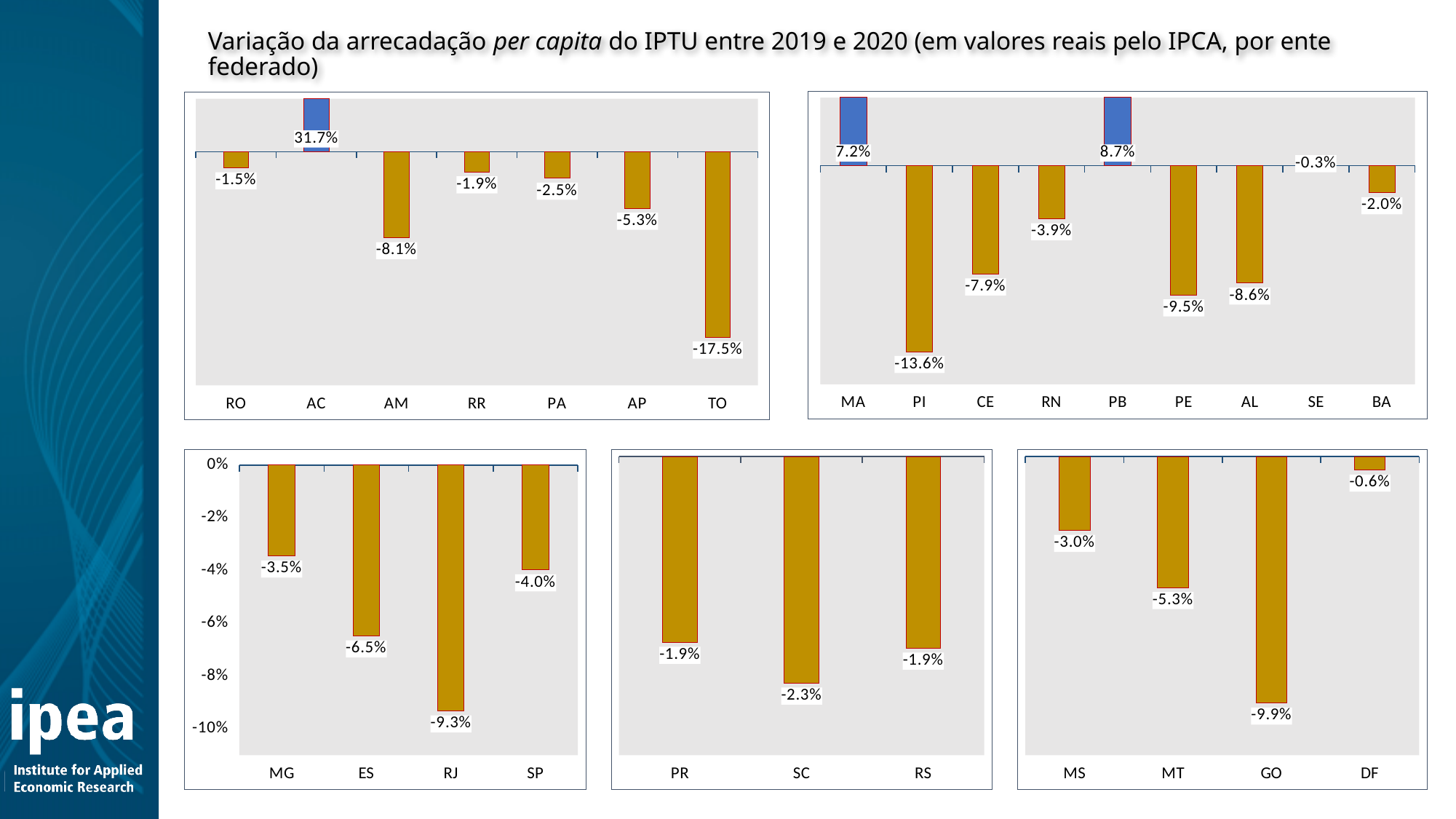
In the top-right chart, which category has the lowest value? PI In the top-left chart, which category has the highest value? AC In the top-left chart, what is the value for TO? -17.5% In the bottom-middle chart, how many categories are shown? 3 In the bottom-middle chart, which category has the lowest value? SC What kind of chart is the bottom-left chart? Bar chart In the top-right chart, what is the value for PB? 8.7% In the bottom-left chart, what is the value for RJ? -9.3% In the bottom-right chart, what is the value for DF? -0.6% In the bottom-left chart, what is the difference between the values for MG and ES? 3.0 percentage points In the top-right chart, how many categories are shown on the x axis? 9 In the bottom-right chart, which is larger, the value for MS or the value for GO? MS